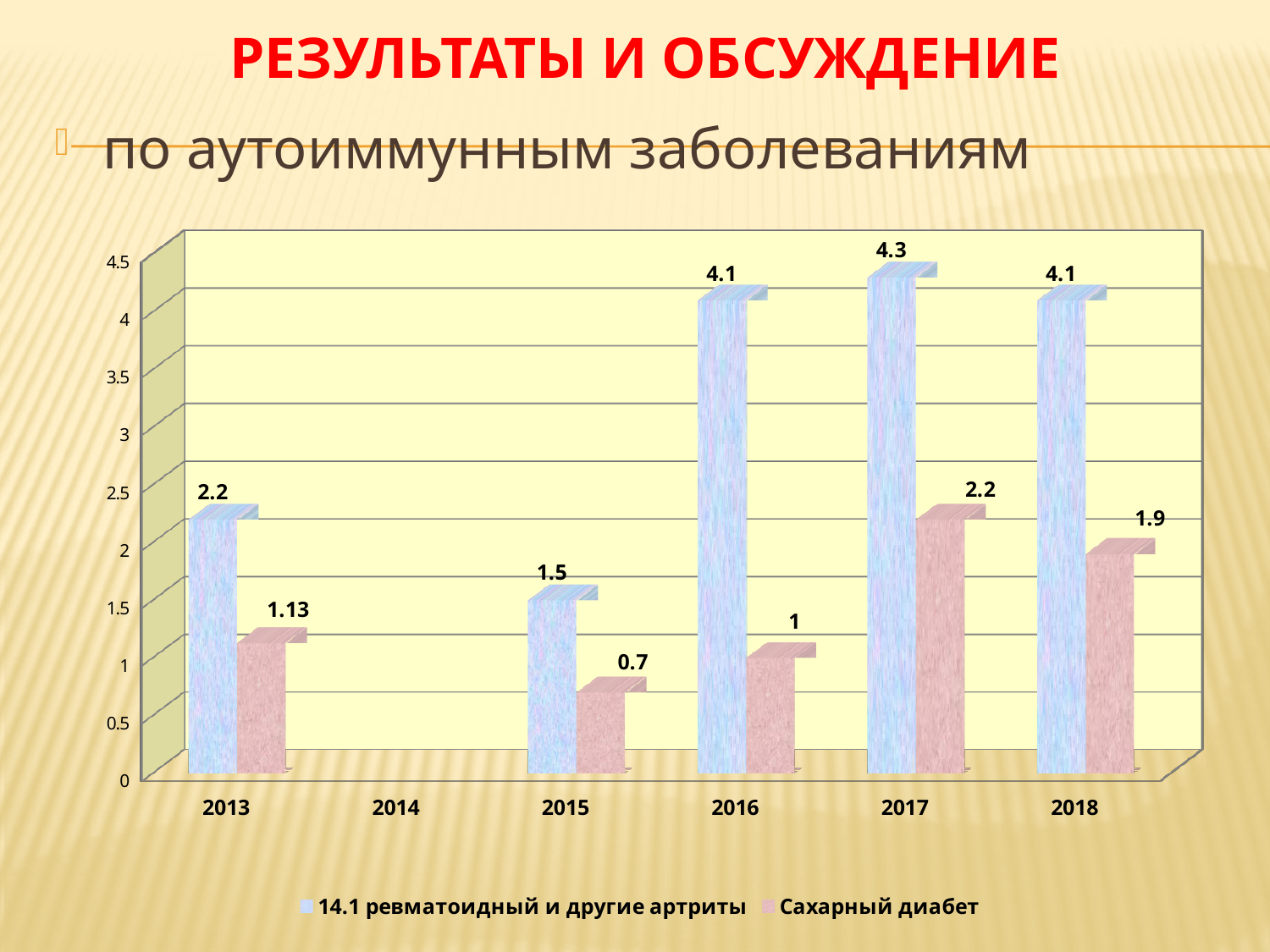
How many series does the legend list? 2 Which is larger: the "Сахарный диабет" value in 2017 or in 2018? 2017 What is the value for "Сахарный диабет" in 2016? 1 What is the difference between the "14.1 ревматоидный и другие артриты" value and the "Сахарный диабет" value in 2018? 2.2 Is the value for "14.1 ревматоидный и другие артриты" in 2016 greater or less than 4? greater What kind of chart is shown on the slide? Bar chart In which year is the value for "Сахарный диабет" lowest? 2015 How many years are shown on the x axis? 6 In which year is the value for "14.1 ревматоидный и другие артриты" highest? 2017 Which year on the x axis has no bars plotted? 2014 What is the value for "Сахарный диабет" in 2013? 1.13 What is the value for "14.1 ревматоидный и другие артриты" in 2017? 4.3